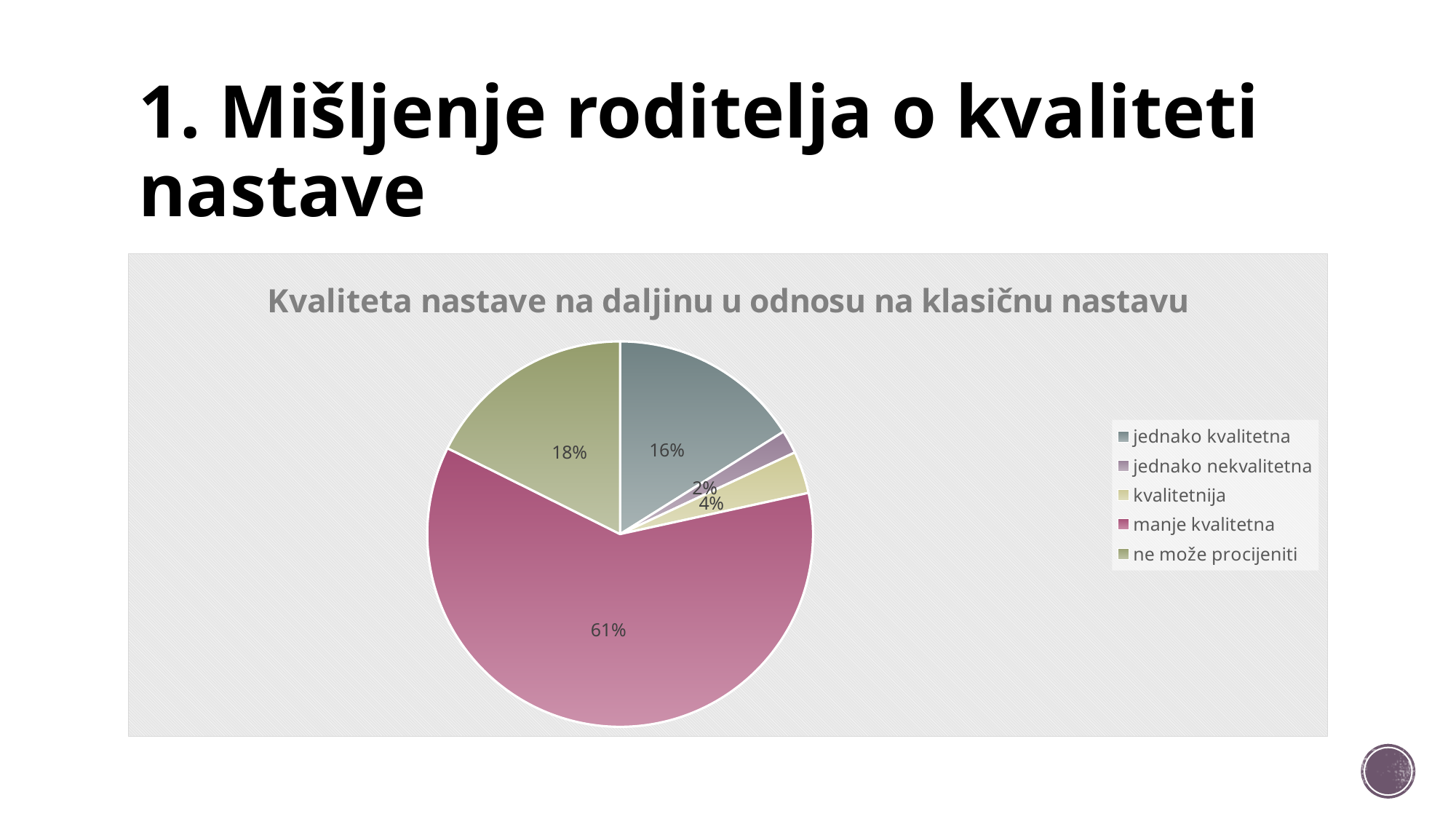
What kind of chart is shown on the slide? pie chart How many categories does the legend list? 5 What share of the pie is labelled "manje kvalitetna"? 61% What share of the pie is labelled "ne može procijeniti"? 18% Which category has the smallest slice of the pie? jednako nekvalitetna Which is larger, the share for "jednako kvalitetna" or the share for "ne može procijeniti"? ne može procijeniti What share of the pie is labelled "kvalitetnija"? 4% Which category has the largest slice of the pie? manje kvalitetna What is the difference between the shares for "manje kvalitetna" and "ne može procijeniti"? 43% What is the title of the chart? Kvaliteta nastave na daljinu u odnosu na klasičnu nastavu